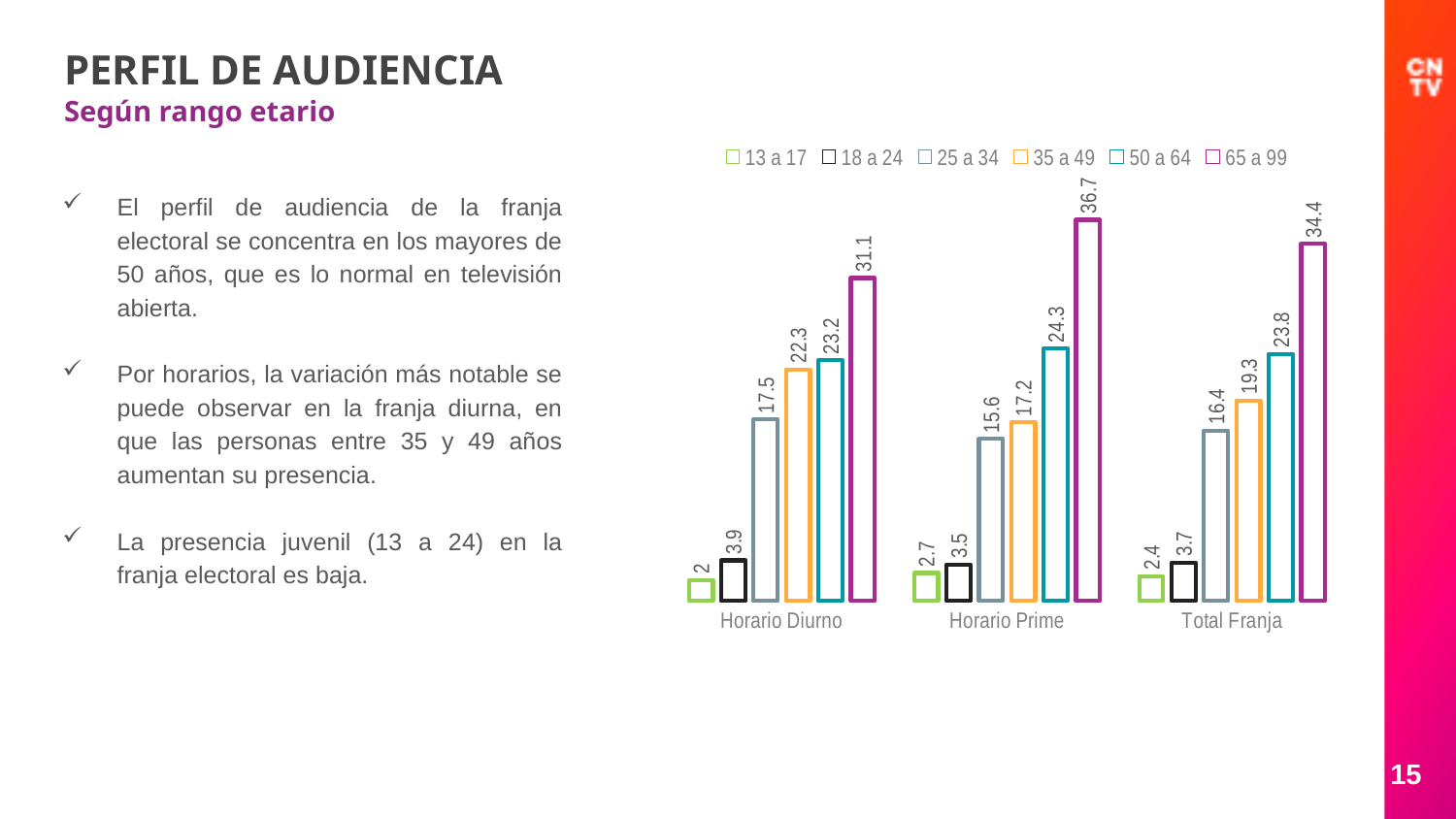
What is the value for the 25 a 34 series in Horario Prime? 15.6 Which age group has the lowest value in Horario Diurno? 13 a 17 How many categories are shown on the x axis? 3 Which age group has the highest value in Total Franja? 65 a 99 What kind of chart is shown on the slide? Bar chart How many series does the legend list? 6 What is the difference between the 65 a 99 values for Horario Prime and Horario Diurno? 5.6 Which is larger: the 35 a 49 value in Horario Diurno or in Horario Prime? Horario Diurno What is the value for the 35 a 49 series in Horario Diurno? 22.3 What is the value for the 65 a 99 series in Horario Prime? 36.7 What is the value for the 13 a 17 series in Total Franja? 2.4 What is the difference between the 50 a 64 and 35 a 49 values in Total Franja? 4.5